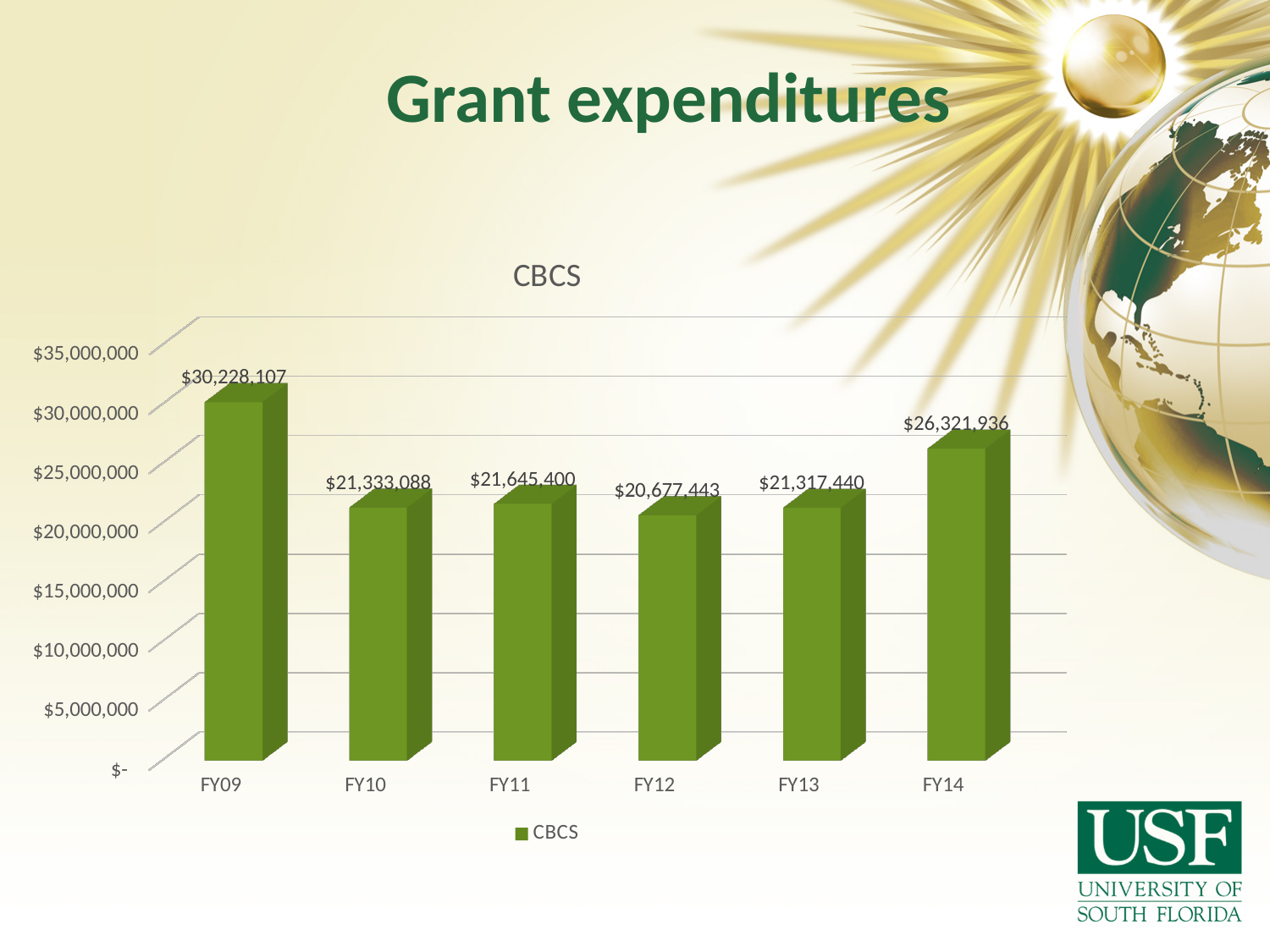
What kind of chart is used to show the CBCS grant expenditures? bar chart What is the CBCS grant expenditure value for FY09? $30,228,107 What is the title of the chart? CBCS Is the CBCS grant expenditure for FY12 greater or less than $25,000,000? less What is the difference between the CBCS grant expenditures for FY14 and FY12? $5,644,493 Which fiscal year has the lowest CBCS grant expenditure? FY12 What is the CBCS grant expenditure value for FY14? $26,321,936 Which fiscal year has the highest CBCS grant expenditure? FY09 What is the difference between the CBCS grant expenditures for FY09 and FY14? $3,906,171 How many fiscal years are shown on the x axis of the chart? 6 Which is larger, the CBCS grant expenditure for FY09 or for FY14? FY09 What is the CBCS grant expenditure value for FY12? $20,677,443